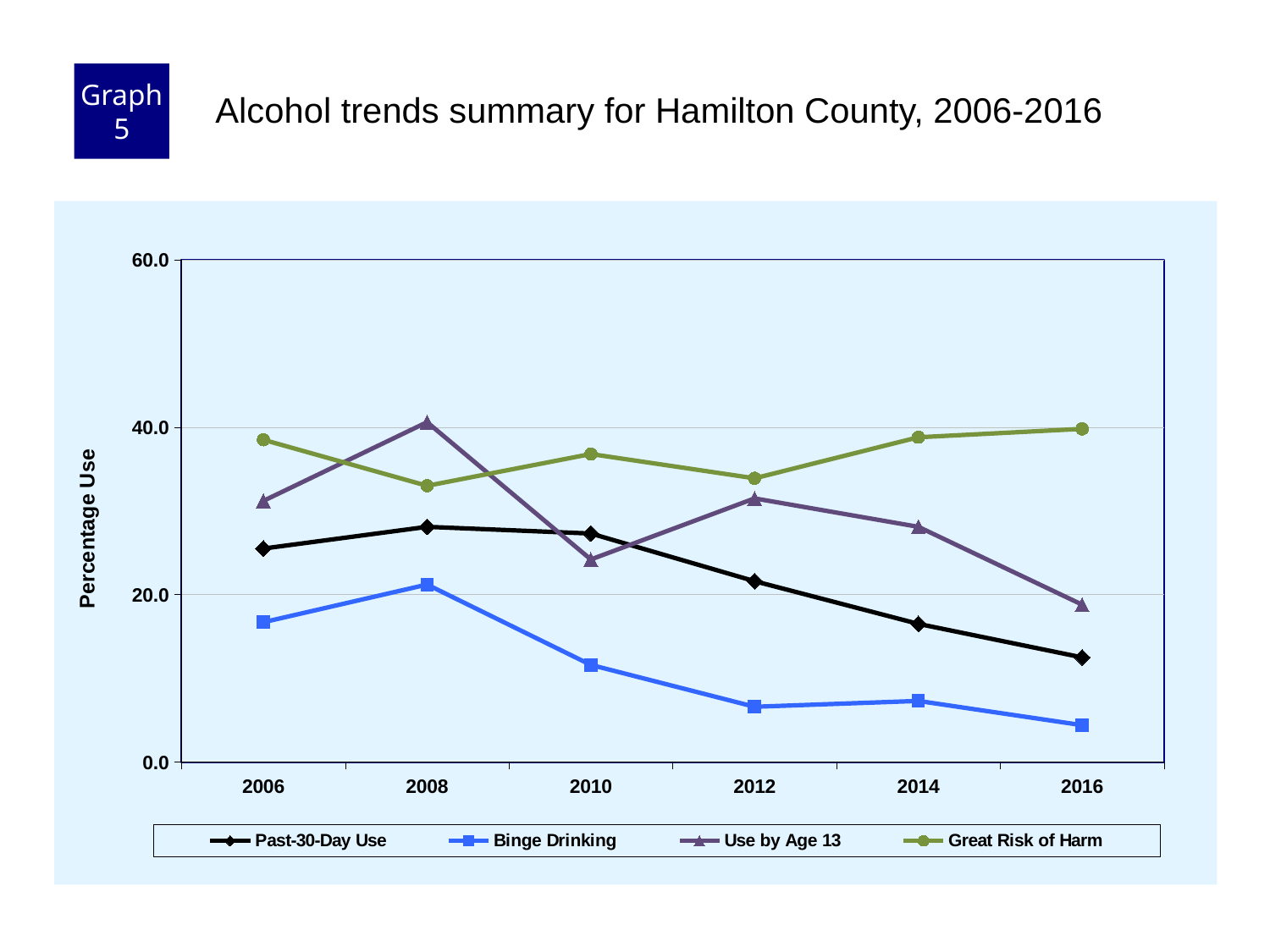
Is the value for Great Risk of Harm in 2008 greater or less than 40? less How many series does the legend list? 4 In which year is Past-30-Day Use lowest? 2016 Does the Past-30-Day Use line rise or fall from 2008 to 2016? Fall What is the label on the y axis? Percentage Use In which year is Use by Age 13 lowest? 2016 Is the value for Past-30-Day Use in 2006 greater or less than 20? greater What kind of chart is shown on the slide? Line chart How many years are plotted along the x axis? 6 In which year is Binge Drinking highest? 2008 Does the Binge Drinking line generally rise or fall from 2006 to 2016? Fall In 2010, which is larger: Past-30-Day Use or Use by Age 13? Past-30-Day Use